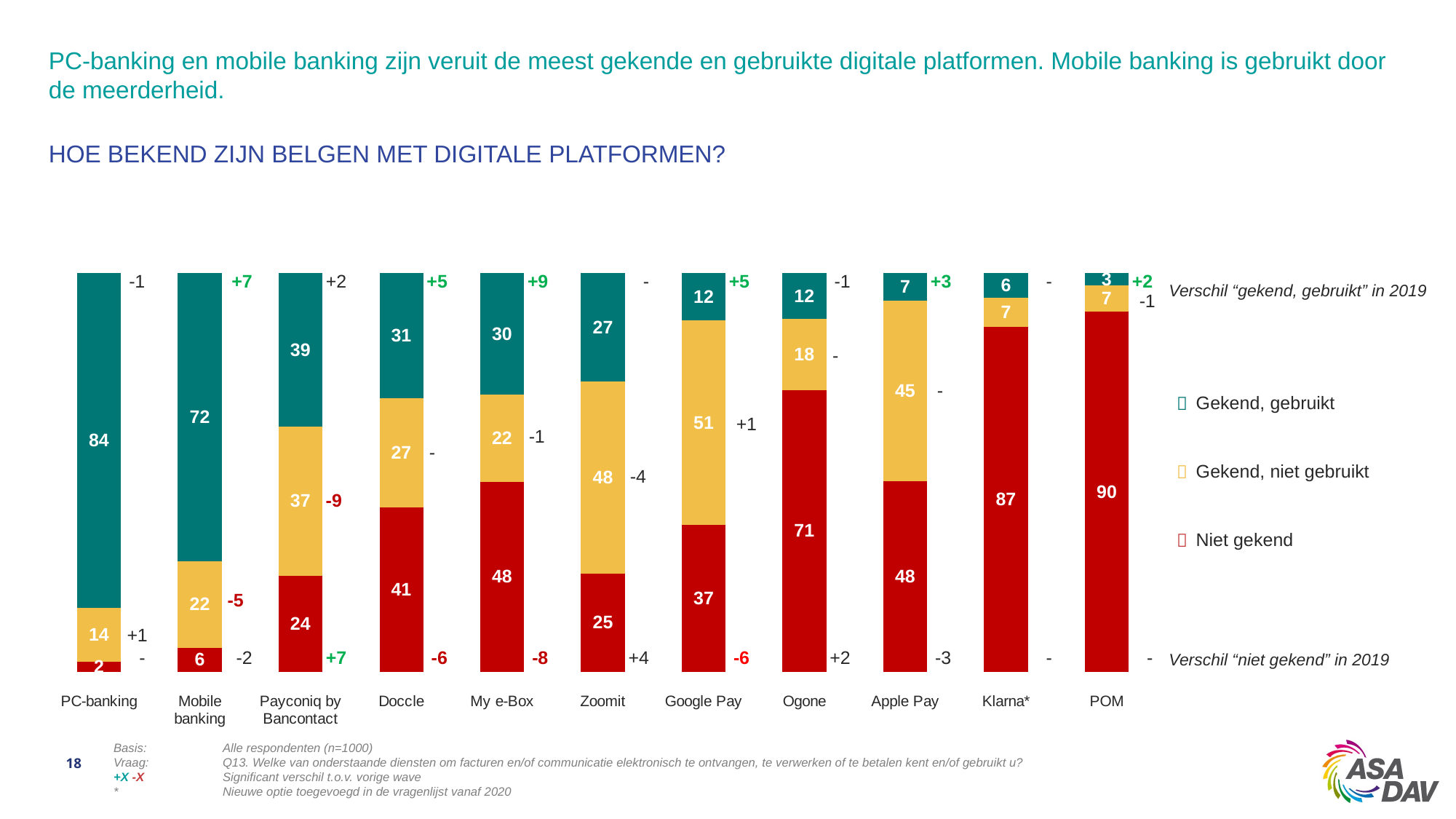
What is the value of "Gekend, niet gebruikt" for Apple Pay? 45 What is the value of "Niet gekend" for Klarna*? 87 What is the title of the chart? HOE BEKEND ZIJN BELGEN MET DIGITALE PLATFORMEN? Which category has the lowest "Gekend, gebruikt" value? POM What kind of chart is shown on the slide? Stacked bar chart How many series does the legend list? 3 Which has the larger "Gekend, niet gebruikt" value, Google Pay or Zoomit? Google Pay What is the total of the stacked bar for PC-banking? 100 How many categories (platforms) are shown on the x axis? 11 What is the value of "Gekend, gebruikt" for PC-banking? 84 Which category has the highest "Niet gekend" value? POM What is the difference between the "Gekend, gebruikt" values for Mobile banking and Payconiq by Bancontact? 33